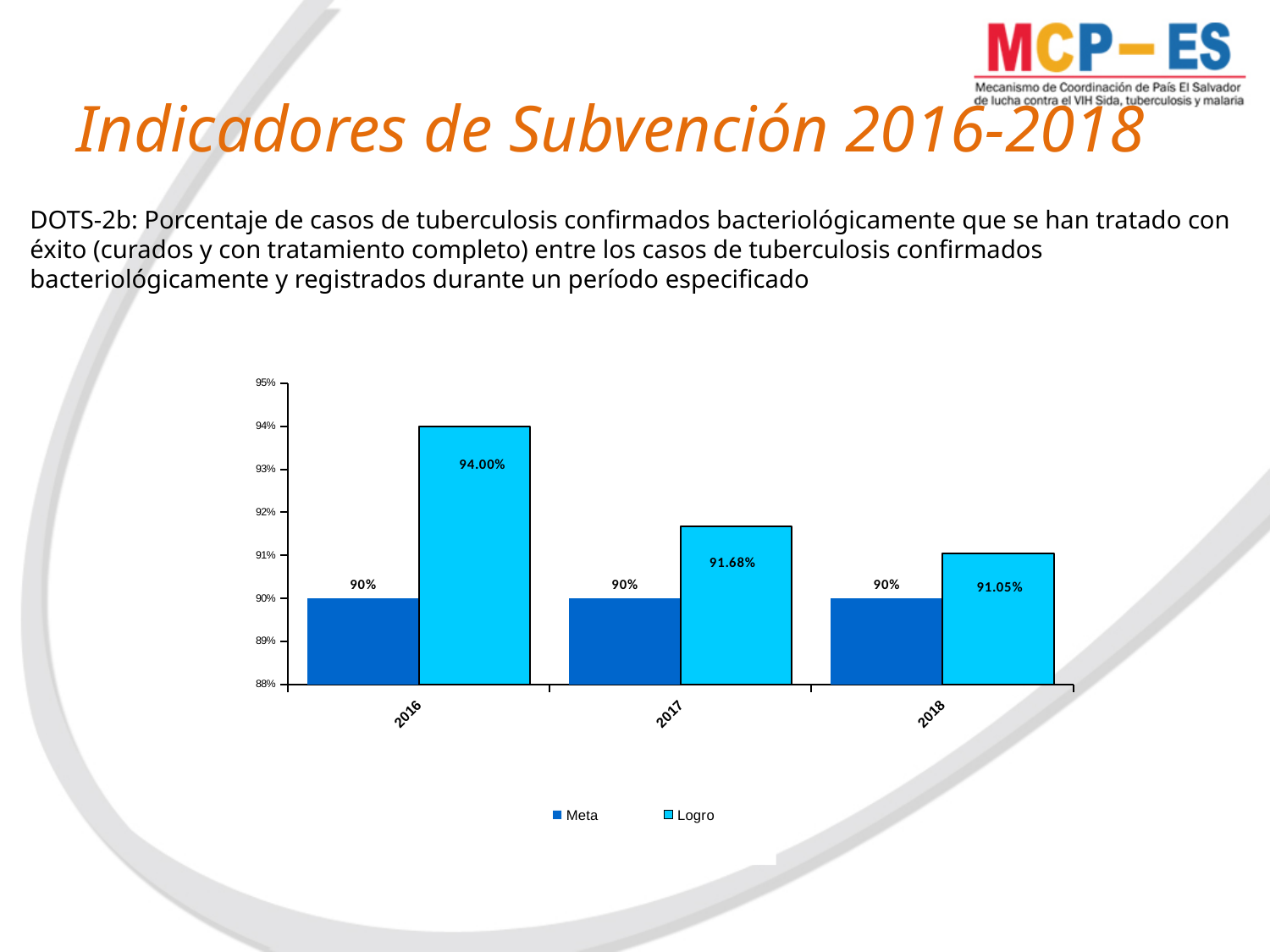
What is the Meta value for 2018? 90% How many series does the legend list? 2 Is the Logro value for 2017 greater or less than 91%? greater What is the Logro value for 2018? 91.05% What is the Logro value for 2016? 94.00% How many years are shown on the x axis? 3 Which year has the lowest Logro value? 2018 Is the Logro value for 2016 larger than the Logro value for 2018? Yes What is the difference between the Logro value for 2016 and the Logro value for 2017? 2.32% What kind of chart is shown on the slide? Bar chart Which year has the highest Logro value? 2016 What is the Logro value for 2017? 91.68%